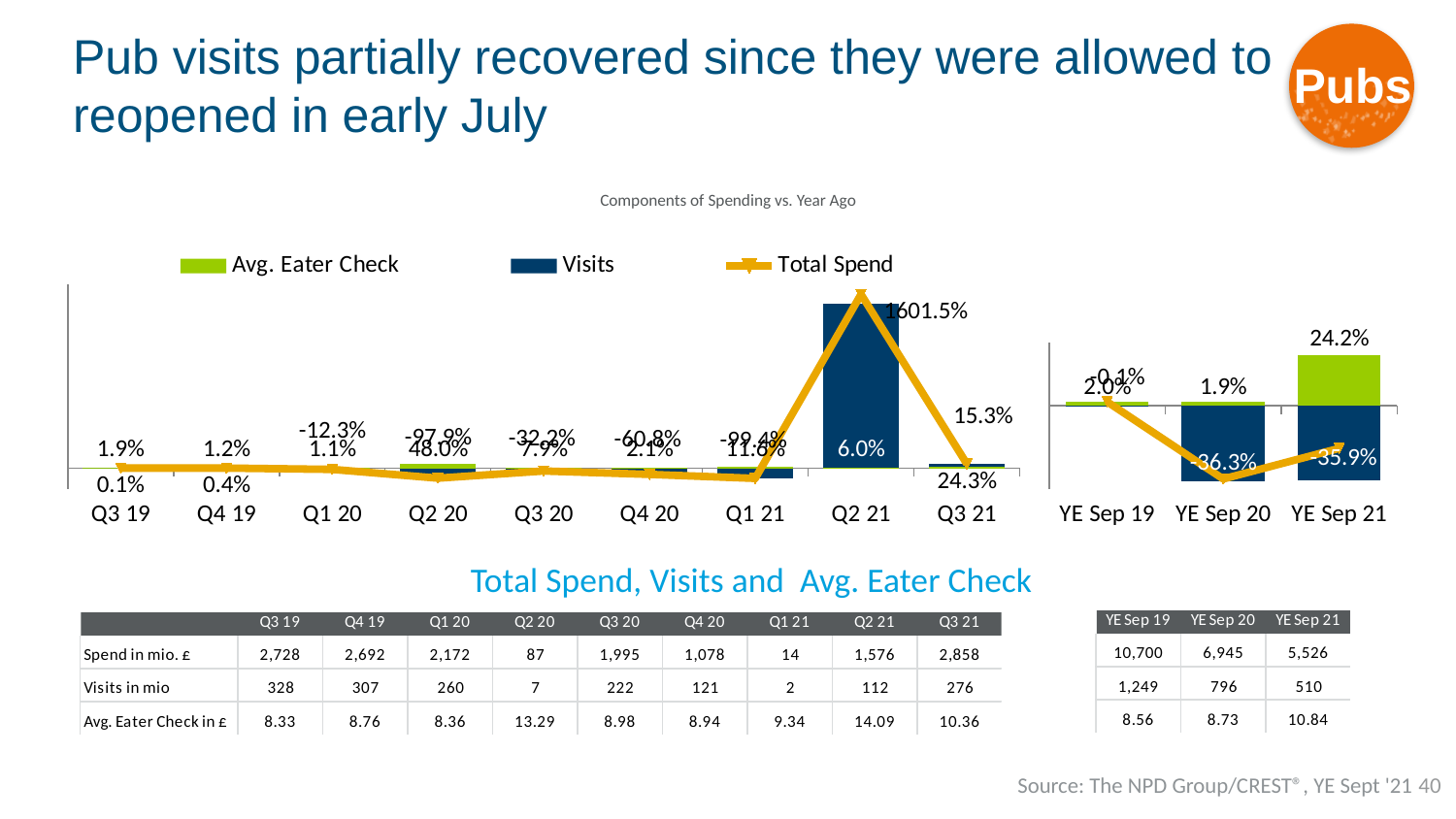
In the quarterly chart on the left, which quarter has the highest Visits value? Q2 21 How many series does the legend list for the charts? 3 In the quarterly chart on the left, what is the Visits value for Q2 21? 1601.5% In the year-ending chart on the right, by how many percentage points is the Avg. Eater Check value for YE Sep 21 higher than for YE Sep 20? 22.3 percentage points What kind of chart is the quarterly chart on the left (Q3 19 to Q3 21)? bar chart with a line In the quarterly chart on the left, what is the Avg. Eater Check value for Q3 21? 15.3% In the quarterly chart on the left, how many quarters are shown on the x axis? 9 In the year-ending chart on the right, what is the Visits value for YE Sep 21? -35.9% In the year-ending chart on the right, what is the Avg. Eater Check value for YE Sep 21? 24.2% In the year-ending chart on the right, how many periods are shown on the x axis? 3 In the year-ending chart on the right, what is the Visits value for YE Sep 20? -36.3% In the quarterly chart on the left, what is the Visits value for Q3 21? 24.3%